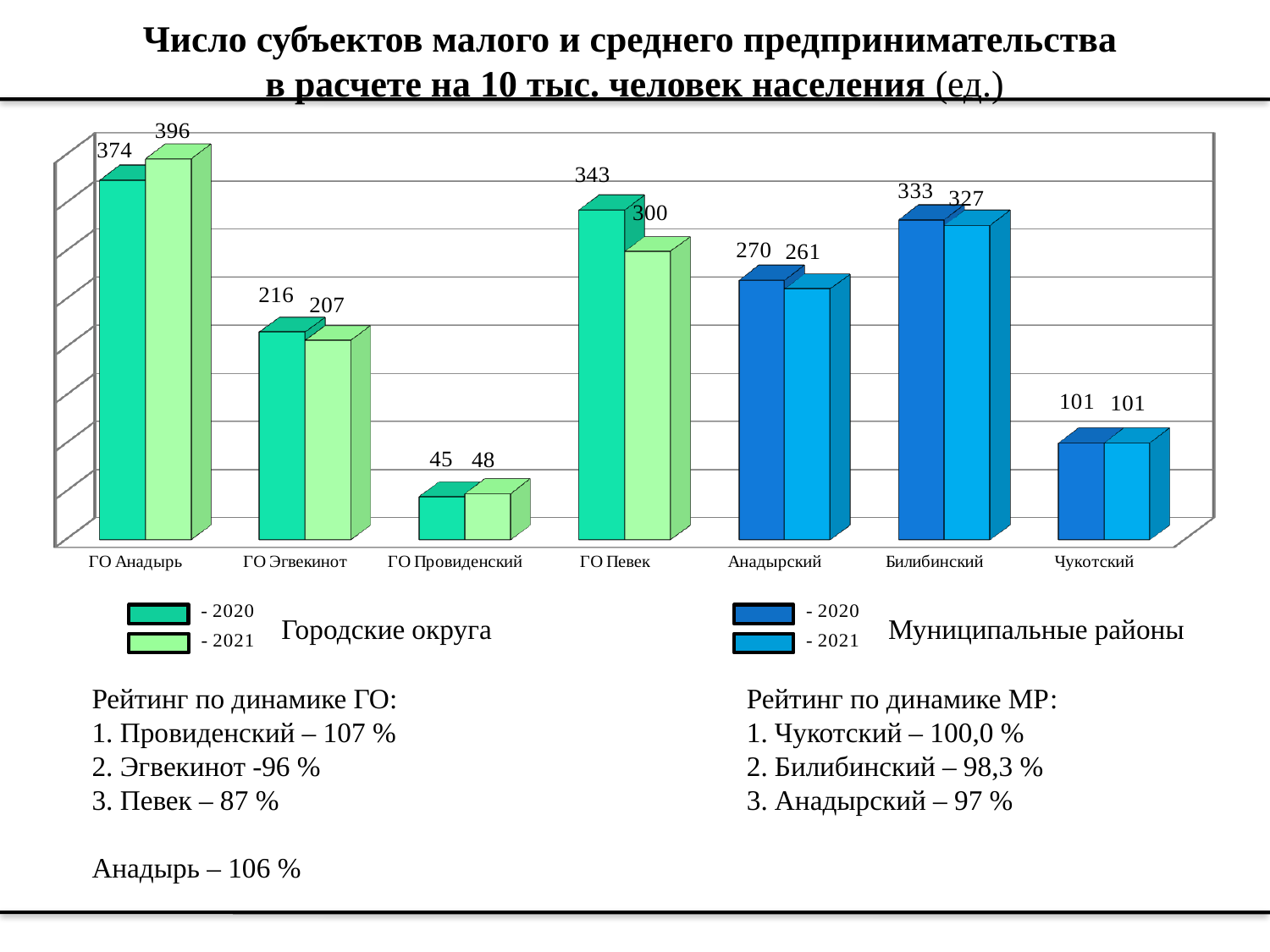
Which category has the lowest value in 2020? ГО Провиденский What is the value for ГО Певек in 2020? 343 What kind of chart is shown on the slide? bar chart What is the value for ГО Провиденский in 2020? 45 Which is larger: the 2020 value for Анадырский or the 2020 value for Билибинский? Билибинский Which two years does the chart compare according to the legend? 2020 and 2021 What is the difference between the 2021 values for ГО Анадырь and Билибинский? 69 What is the value for Билибинский in 2021? 327 How many categories are shown on the x axis? 7 Which category has the highest value in 2021? ГО Анадырь What is the value for ГО Анадырь in 2021? 396 What is the difference between the 2020 and 2021 values for ГО Певек? 43